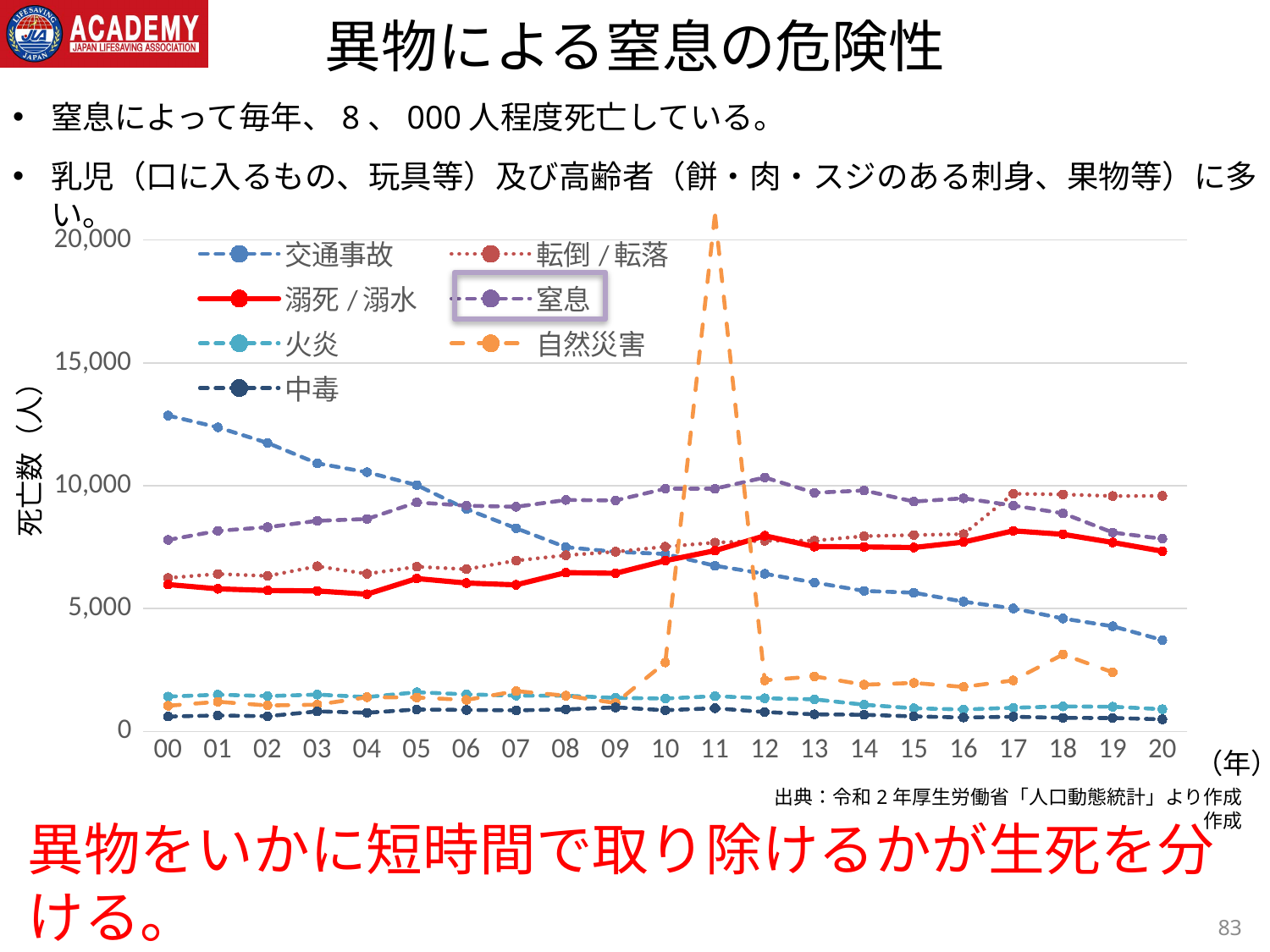
In 00, which is larger: 交通事故 or 窒息? 交通事故 How many years are plotted along the x axis of the chart? 21 Is the value for 自然災害 in 11 greater or less than 20,000? greater Which series has the highest value in 11? 自然災害 What kind of chart is shown on the slide? line chart Which legend entry is highlighted with a box on the chart? 窒息 How many series does the chart's legend list? 7 Is the value for 交通事故 in 00 greater or less than 10,000? greater Does the 交通事故 series rise or fall from 00 to 20? fall Which series has the lowest value in 20? 中毒 In 20, which is larger: 窒息 or 交通事故? 窒息 Is the value for 溺死／溺水 in 00 greater or less than 5,000? greater